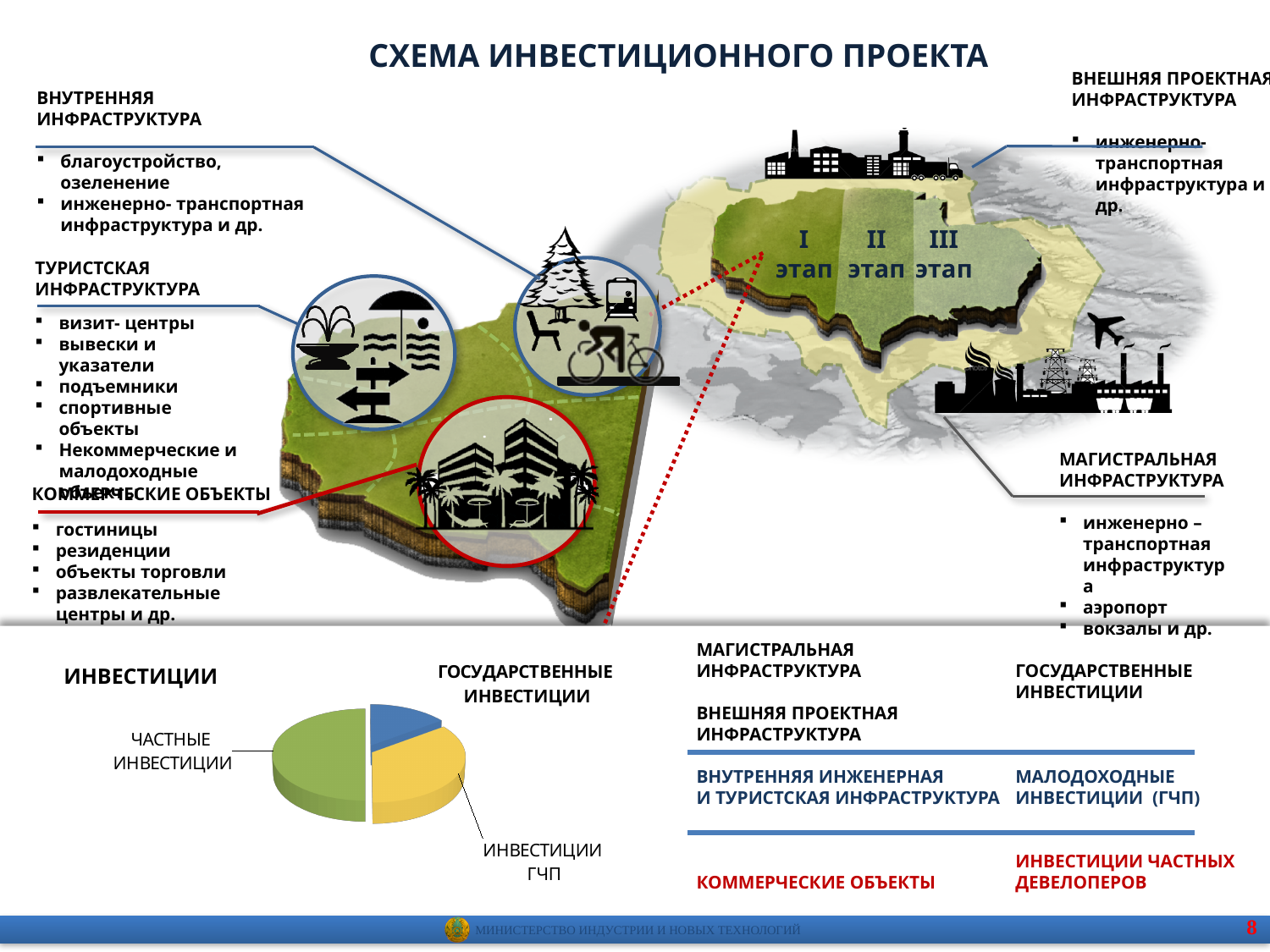
Which slice of the pie chart is the smallest? ГОСУДАРСТВЕННЫЕ ИНВЕСТИЦИИ What is the title of the pie chart on the slide? ИНВЕСТИЦИИ What colour is the ЧАСТНЫЕ ИНВЕСТИЦИИ slice in the pie chart? Green In the pie chart, which is larger: ЧАСТНЫЕ ИНВЕСТИЦИИ or ИНВЕСТИЦИИ ГЧП? ЧАСТНЫЕ ИНВЕСТИЦИИ How many slices does the pie chart have? 3 What kind of chart is shown in the bottom-left of the slide? Pie chart Which slice of the pie chart is the largest? ЧАСТНЫЕ ИНВЕСТИЦИИ In the pie chart, which is larger: ИНВЕСТИЦИИ ГЧП or ГОСУДАРСТВЕННЫЕ ИНВЕСТИЦИИ? ИНВЕСТИЦИИ ГЧП